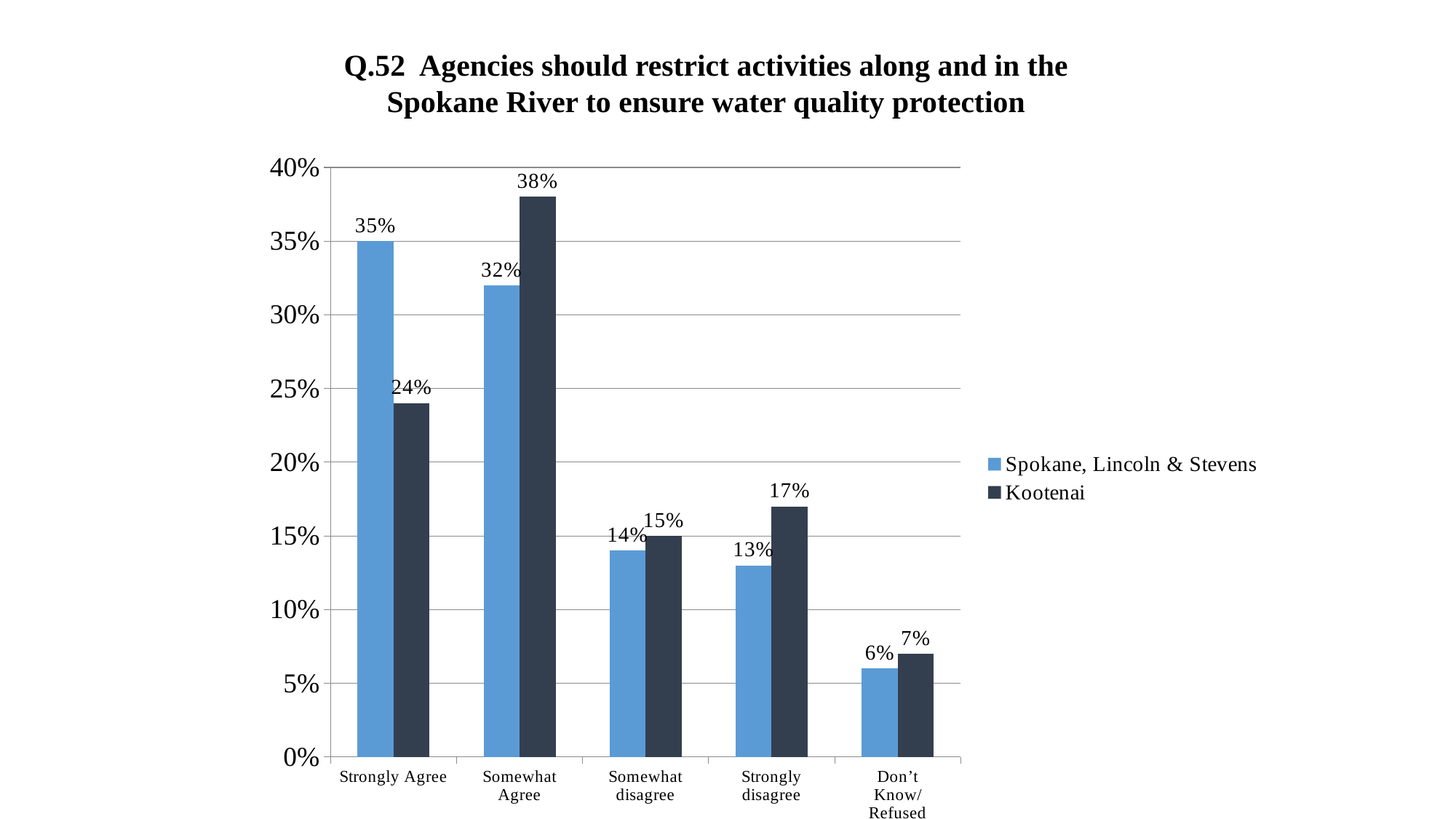
Which series is shown in the lighter blue colour? Spokane, Lincoln & Stevens Which category has the highest value for Spokane, Lincoln & Stevens? Strongly Agree What is the value for Kootenai in the Somewhat Agree category? 38% What kind of chart is shown on the slide? Bar chart How many series does the legend list? 2 What is the value for Spokane, Lincoln & Stevens in the Strongly Agree category? 35% Which category has the lowest value for Kootenai? Don't Know/Refused What is the difference between the Kootenai and Spokane, Lincoln & Stevens values for Strongly Agree? 11% What is the difference between the Kootenai and Spokane, Lincoln & Stevens values for Somewhat Agree? 6% How many response categories are shown on the x axis? 5 What is the value for Kootenai in the Strongly disagree category? 17% Which series has the larger value in the Strongly disagree category? Kootenai